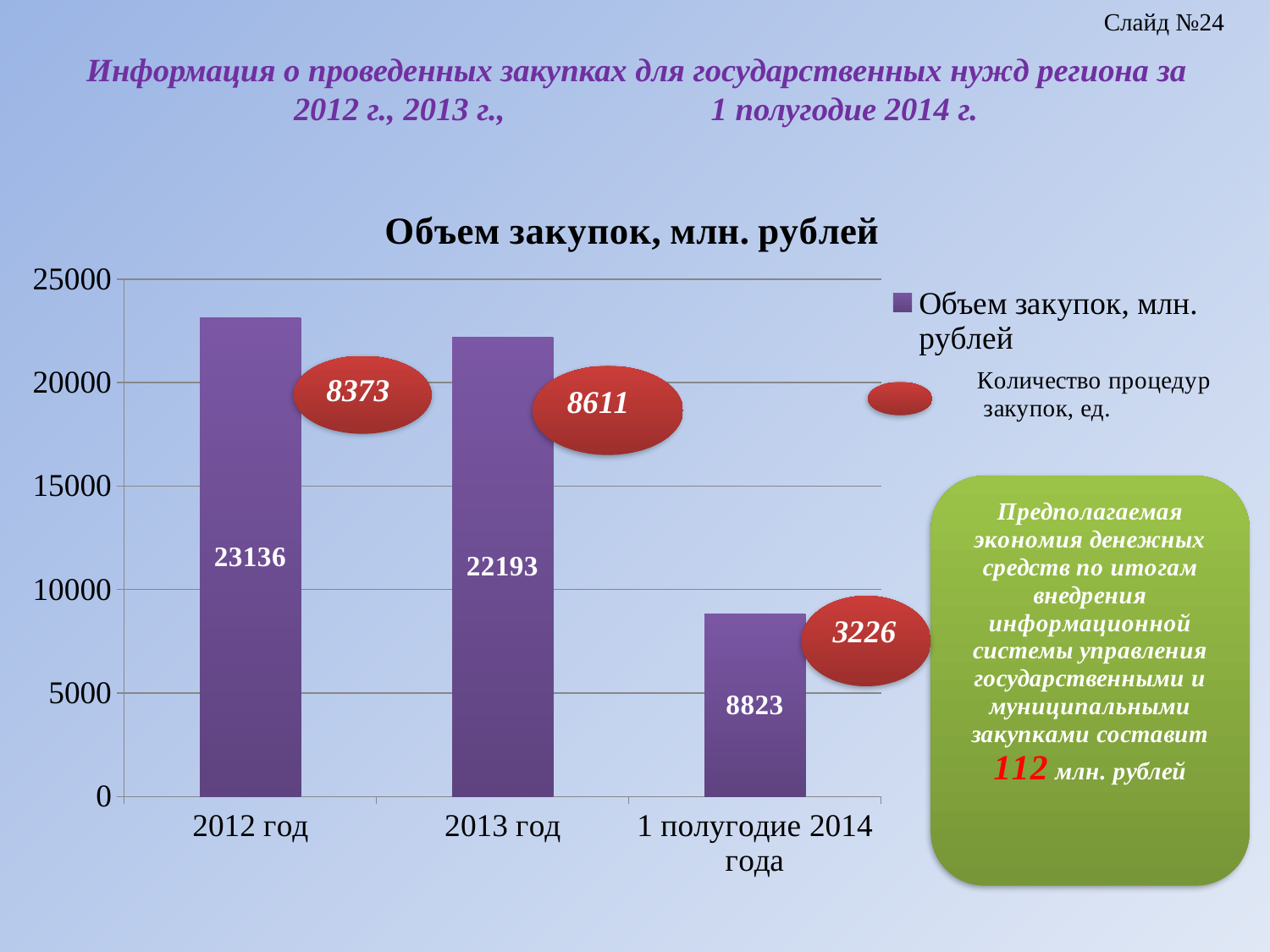
What is the value for 2013 год? 22193 What is the value for 1 полугодие 2014 года? 8823 What number of procurement procedures (Количество процедур закупок, ед.) is shown in the red oval for 2013 год? 8611 What is the value for 2012 год? 23136 What type of chart is shown on the slide? bar chart Which is larger, the value for 2013 год or the value for 1 полугодие 2014 года? 2013 год Which category has the highest value? 2012 год Do the values rise or fall from 2012 год to 1 полугодие 2014 года? fall How many categories are shown on the x axis? 3 Which category has the lowest value? 1 полугодие 2014 года What is the difference between the values for 2012 год and 2013 год? 943 What is the title of the chart? Объем закупок, млн. рублей